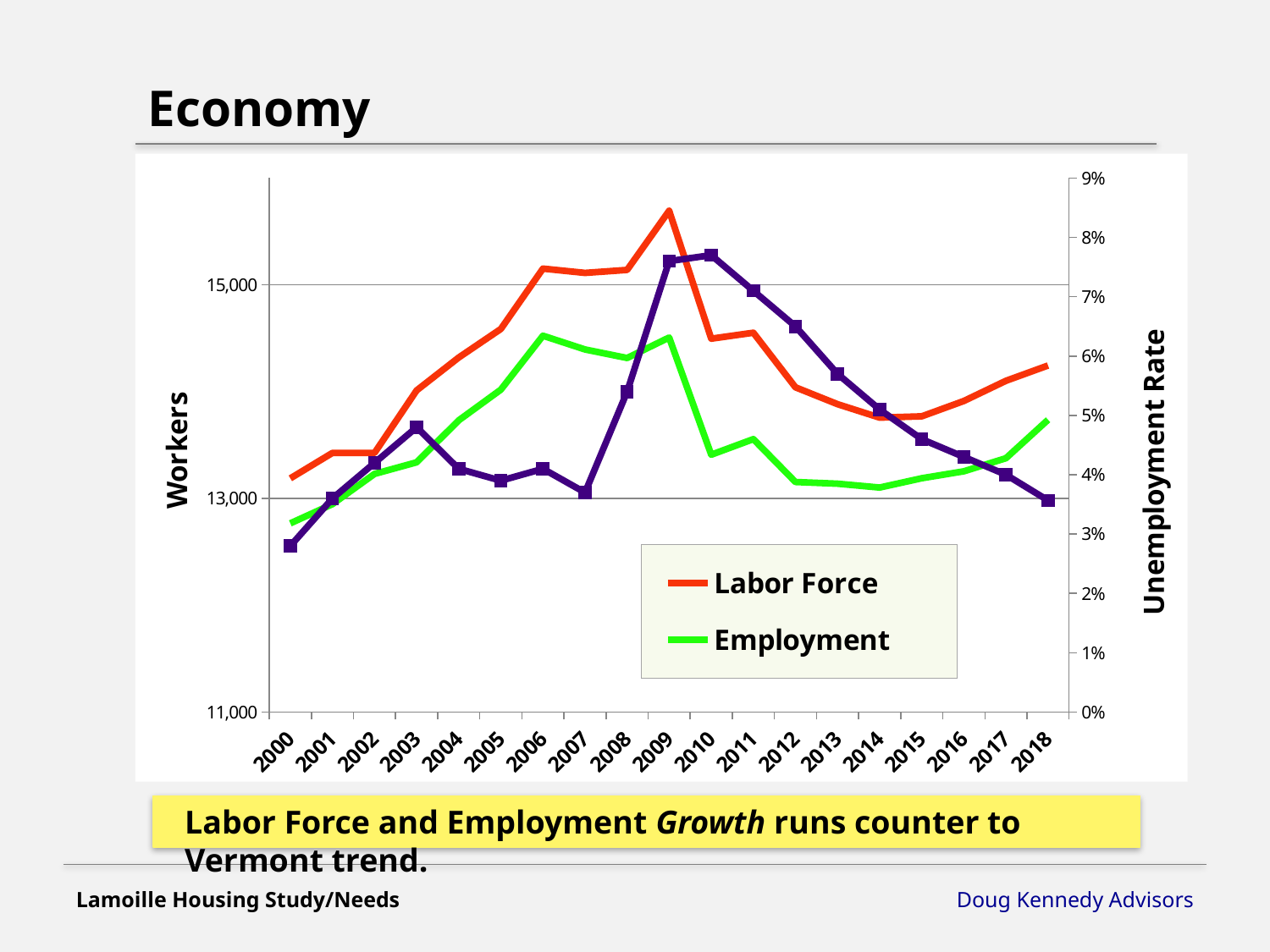
What kind of chart is shown on the slide? line chart How many series does the chart's legend list? 2 In which year is the Employment series at its lowest value? 2000 Is the Employment value for 2000 greater or less than 13,000? less How many years are plotted along the x axis? 19 Is the Labor Force value for 2014 greater or less than 13,000? greater Does the Labor Force series rise or fall from 2014 to 2018? rise In which year is the Labor Force series at its lowest value? 2000 In which year does the Labor Force series reach its highest value? 2009 Is the Labor Force value for 2009 greater or less than 15,000? greater In 2009, which is larger: Labor Force or Employment? Labor Force What is the title of the right-hand vertical axis? Unemployment Rate